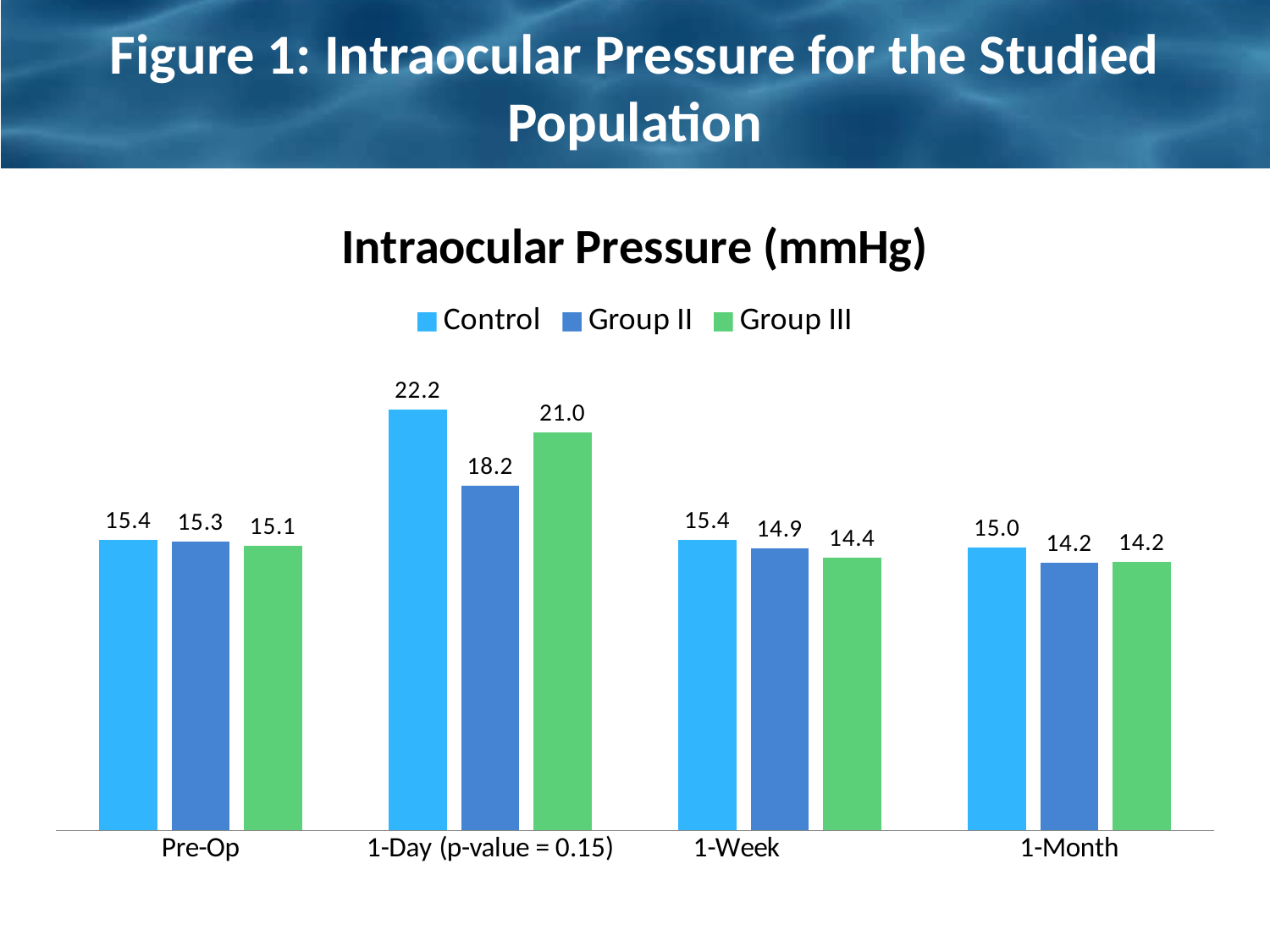
What kind of chart is shown? Bar chart At which time point is the Control value highest? 1-Day What is the Control value at 1-Day? 22.2 Does the Group II value rise or fall from 1-Day to 1-Month? Fall What is the Group II value at 1-Week? 14.9 What is the difference between the Control and Group II values at 1-Day? 4.0 At 1-Day, which is larger: the Group II value or the Group III value? Group III What is the chart's title? Intraocular Pressure (mmHg) How many series does the legend list? 3 What is the Group III value at Pre-Op? 15.1 At which time point is the Group III value lowest? 1-Month How many time-point categories are shown on the x axis? 4